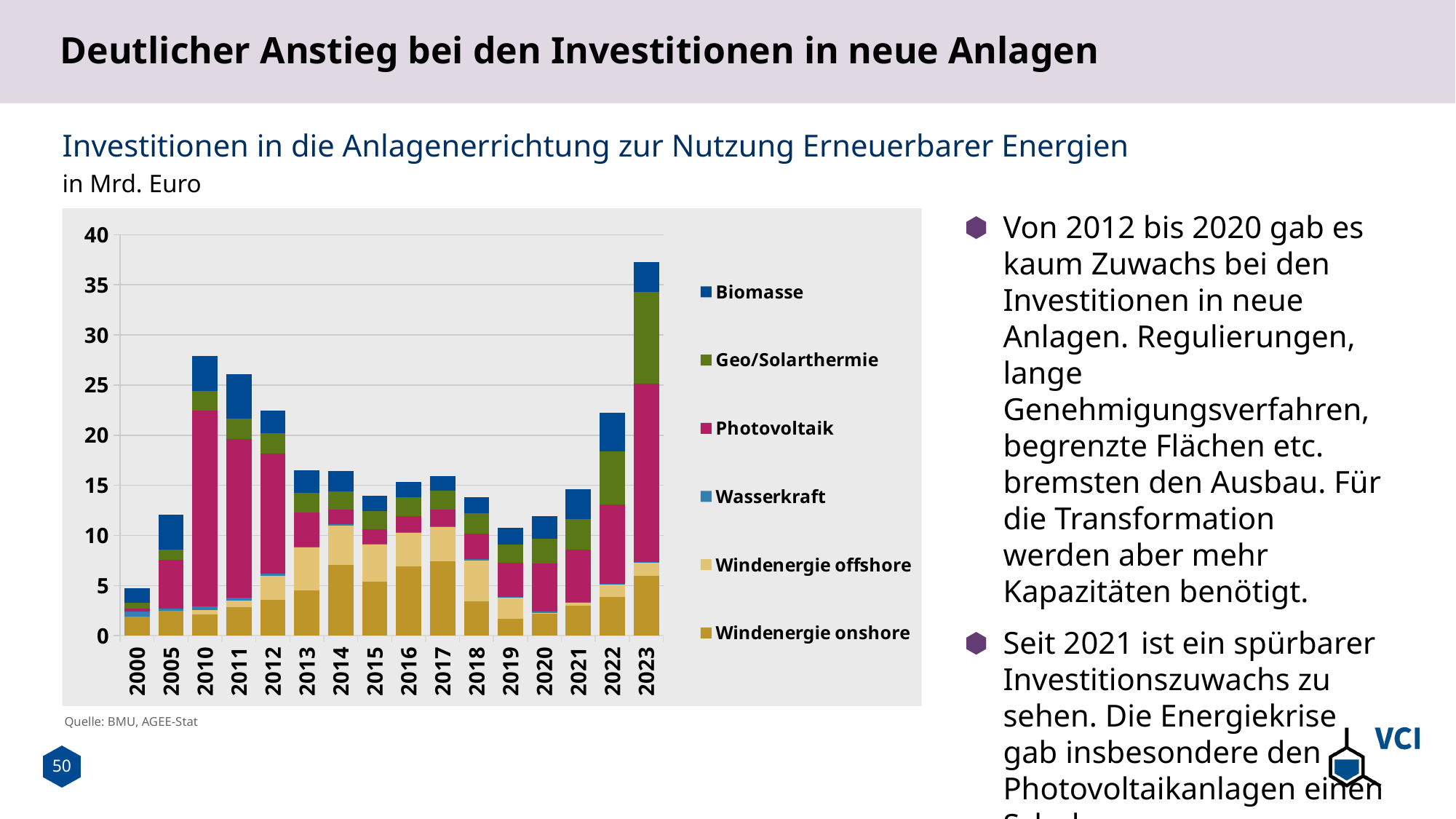
Is the total value for 2023 greater or less than 35? greater Which year has the lowest total investment in the chart? 2000 In what unit are the values in the chart given? Mrd. Euro What kind of chart is shown on the slide? Stacked bar chart Is the total value for 2010 greater or less than 25? greater How many series does the chart's legend list? 6 Which year has the larger total investment, 2010 or 2011? 2010 How many years are shown on the x axis of the chart? 16 Is the total value for 2019 greater or less than 15? less Do the total investments rise or fall from 2021 to 2023? rise Which year has the highest total investment in the chart? 2023